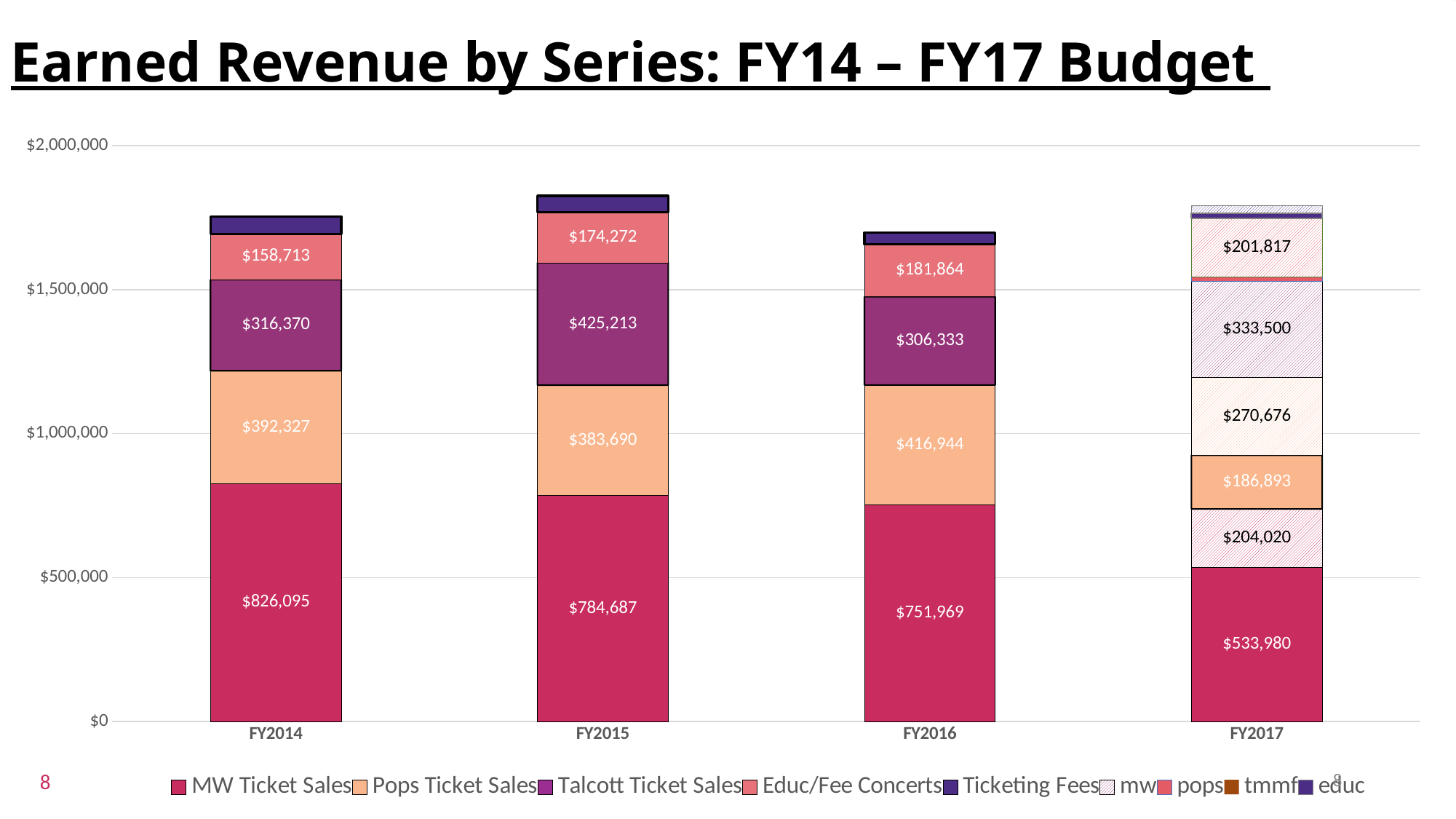
Which fiscal year has the highest MW Ticket Sales? FY2014 How many series does the legend list? 9 Which fiscal year has the lowest MW Ticket Sales? FY2017 How many fiscal years are shown on the x axis? 4 What is the difference between MW Ticket Sales in FY2014 and FY2015? $41,408 Is the total height of the FY2015 stacked bar greater or less than $1,500,000? greater What is the value of Educ/Fee Concerts for FY2016? $181,864 What is the value of MW Ticket Sales for FY2014? $826,095 What is the value of Talcott Ticket Sales for FY2015? $425,213 Which is larger: Pops Ticket Sales in FY2014 or in FY2016? FY2016 What is the difference between Talcott Ticket Sales in FY2015 and FY2016? $118,880